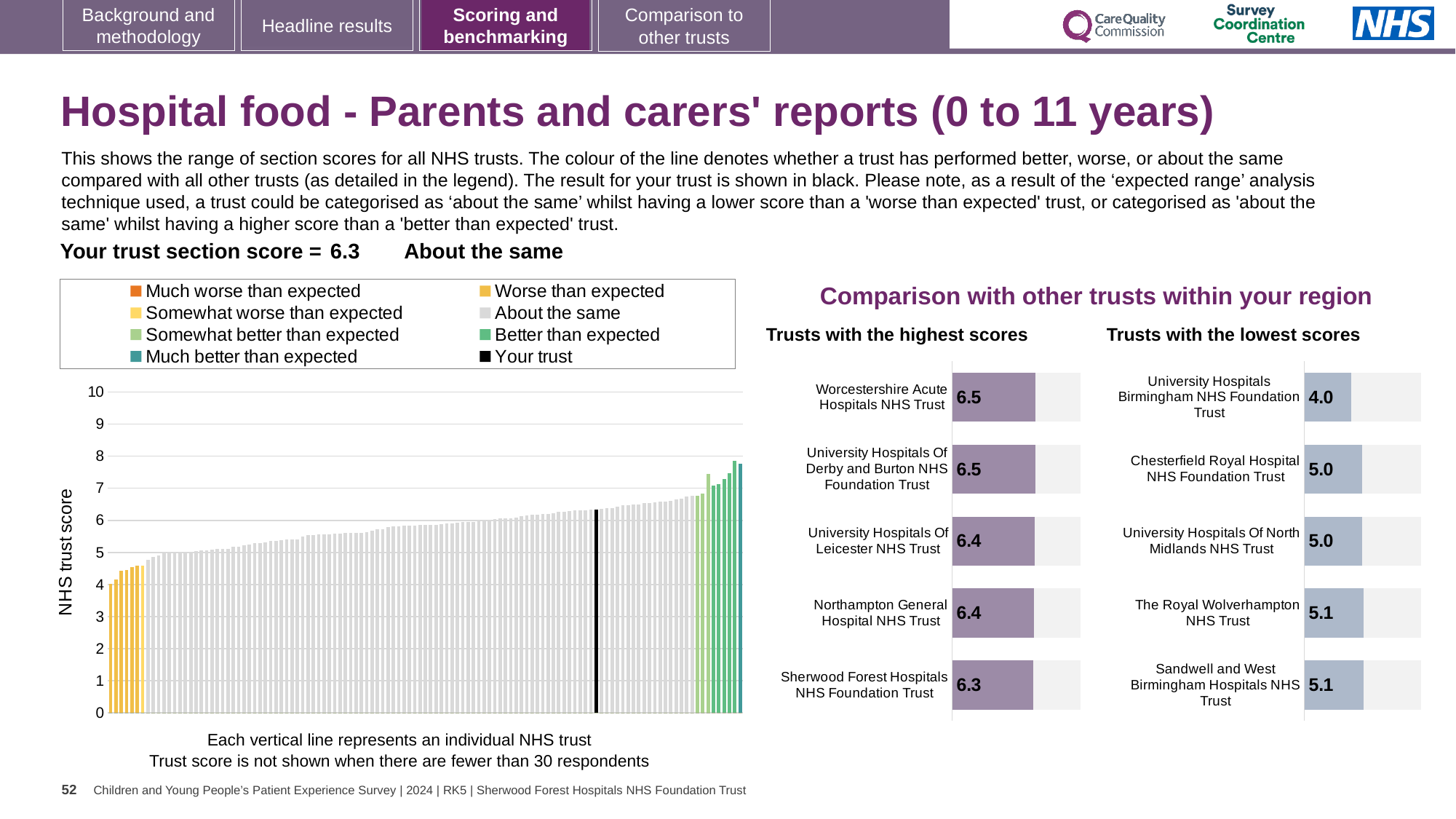
In the 'Trusts with the highest scores' chart, what is the score for Sherwood Forest Hospitals NHS Foundation Trust? 6.3 In the large chart on the left, is the value of the tallest bar greater or less than 7? greater In the 'Trusts with the lowest scores' chart, which has the larger score: University Hospitals Of North Midlands NHS Trust or The Royal Wolverhampton NHS Trust? The Royal Wolverhampton NHS Trust In the 'Trusts with the lowest scores' chart, what is the score for Chesterfield Royal Hospital NHS Foundation Trust? 5.0 In the large chart on the left, do the trust scores rise or fall from left to right? Rise What kind of chart is the large chart on the left showing NHS trust scores? Bar chart In the 'Trusts with the lowest scores' chart, which trust has the lowest score? University Hospitals Birmingham NHS Foundation Trust How many entries does the legend of the large chart on the left list? 8 In the 'Trusts with the highest scores' chart, how many trusts are listed? 5 In the 'Trusts with the highest scores' chart, what is the score for Worcestershire Acute Hospitals NHS Trust? 6.5 In the 'Trusts with the lowest scores' chart, what is the difference between the scores of Sandwell and West Birmingham Hospitals NHS Trust and University Hospitals Birmingham NHS Foundation Trust? 1.1 In the 'Trusts with the highest scores' chart, what is the difference between the scores of Worcestershire Acute Hospitals NHS Trust and Sherwood Forest Hospitals NHS Foundation Trust? 0.2